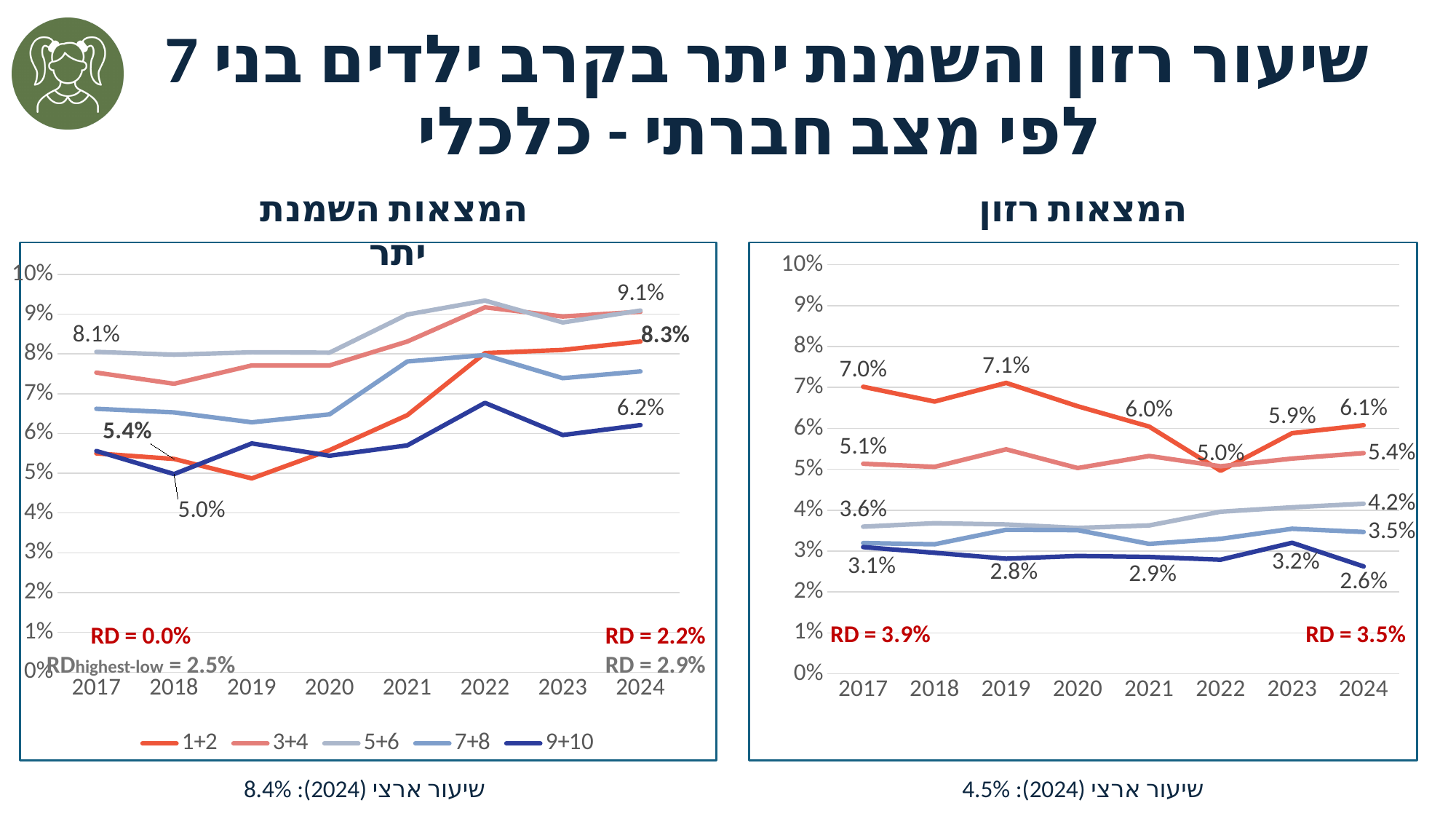
In the right-hand chart 'המצאות רזון', which series has the highest value in 2024? 1+2 In the right-hand chart 'המצאות רזון', what is the value for series 1+2 in 2019? 7.1% In the right-hand chart 'המצאות רזון', which series has the lowest value in 2024? 9+10 How many series does the legend of the left-hand chart 'המצאות השמנת יתר' list? 5 In the right-hand chart 'המצאות רזון', what is the difference between the 1+2 value in 2017 (7.0%) and in 2024 (6.1%)? 0.9% In the left-hand chart 'המצאות השמנת יתר', what is the value for series 5+6 in 2024? 9.1% In the left-hand chart 'המצאות השמנת יתר', is the value for series 3+4 in 2024 greater or less than 8%? greater In the left-hand chart 'המצאות השמנת יתר', what is the value for series 9+10 in 2018? 5.0% What type of chart is the right-hand chart titled 'המצאות רזון'? line chart In the right-hand chart 'המצאות רזון', what is the value for series 9+10 in 2024? 2.6% In the right-hand chart 'המצאות רזון', does the 5+6 series rise or fall from 2017 to 2024? rise How many years are shown on the x axis of the right-hand chart 'המצאות רזון'? 8